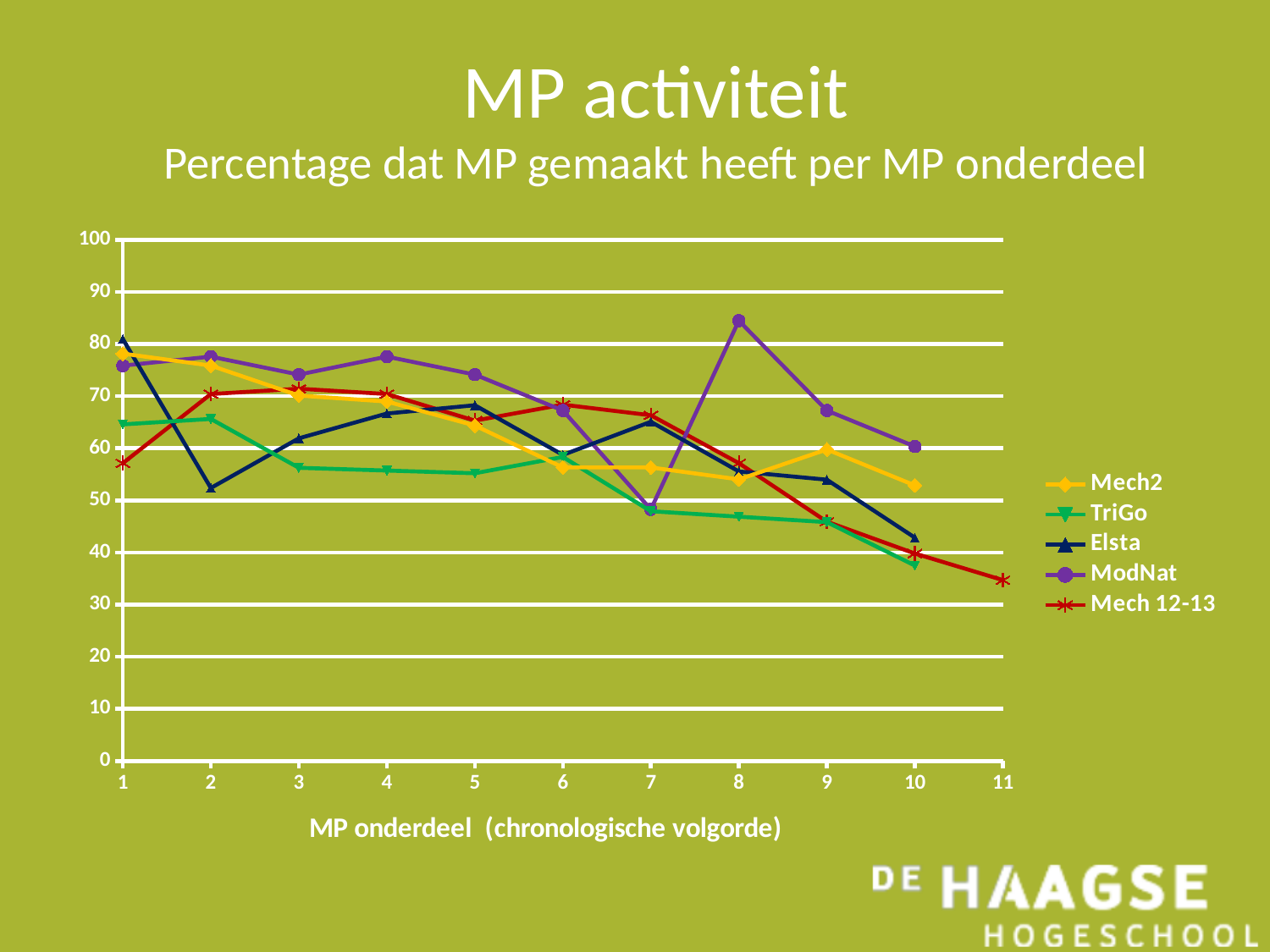
At MP onderdeel 1, which is larger: Elsta or Mech 12-13? Elsta Which series has the lowest value at MP onderdeel 2? Elsta Is the value for ModNat at MP onderdeel 8 greater or less than 80? greater Is the value for Elsta at MP onderdeel 2 greater or less than 60? less Which series has the highest value at MP onderdeel 8? ModNat Is the value for Mech2 at MP onderdeel 1 greater or less than 70? greater How many series does the legend list? 5 How many MP onderdeel points are shown on the x axis? 11 Does the Mech 12-13 series rise or fall from MP onderdeel 8 to 11? fall What is the title of the x axis? MP onderdeel (chronologische volgorde) What kind of chart is shown on the slide? line chart